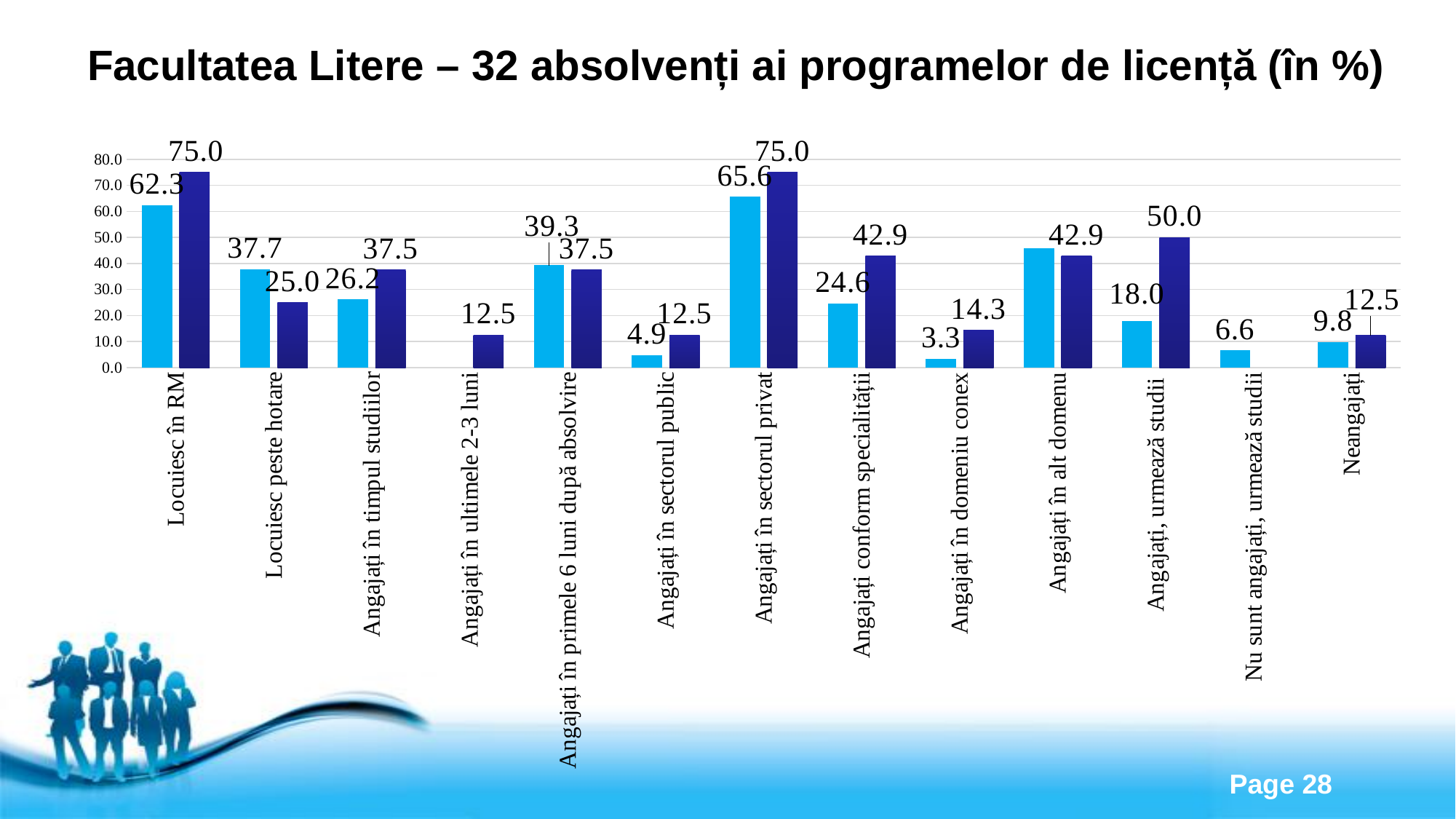
For "Locuiesc peste hotare", which bar is larger, the light blue or the dark blue? light blue What is the dark blue bar value for "Angajați, urmează studii"? 50.0 Which category has the lowest light blue bar value? Angajați în domeniu conex What type of chart is shown on the slide? bar chart How many categories are shown on the x axis? 13 Is the light blue bar value for "Angajați în sectorul privat" greater or less than 60.0? greater What is the difference between the dark blue and light blue bars for "Locuiesc în RM"? 12.7 What is the dark blue bar value for "Angajați conform specialității"? 42.9 What is the light blue bar value for "Locuiesc în RM"? 62.3 What is the light blue bar value for "Angajați în domeniu conex"? 3.3 What is the light blue bar value for "Angajați în sectorul privat"? 65.6 What is the difference between the dark blue and light blue bars for "Angajați, urmează studii"? 32.0